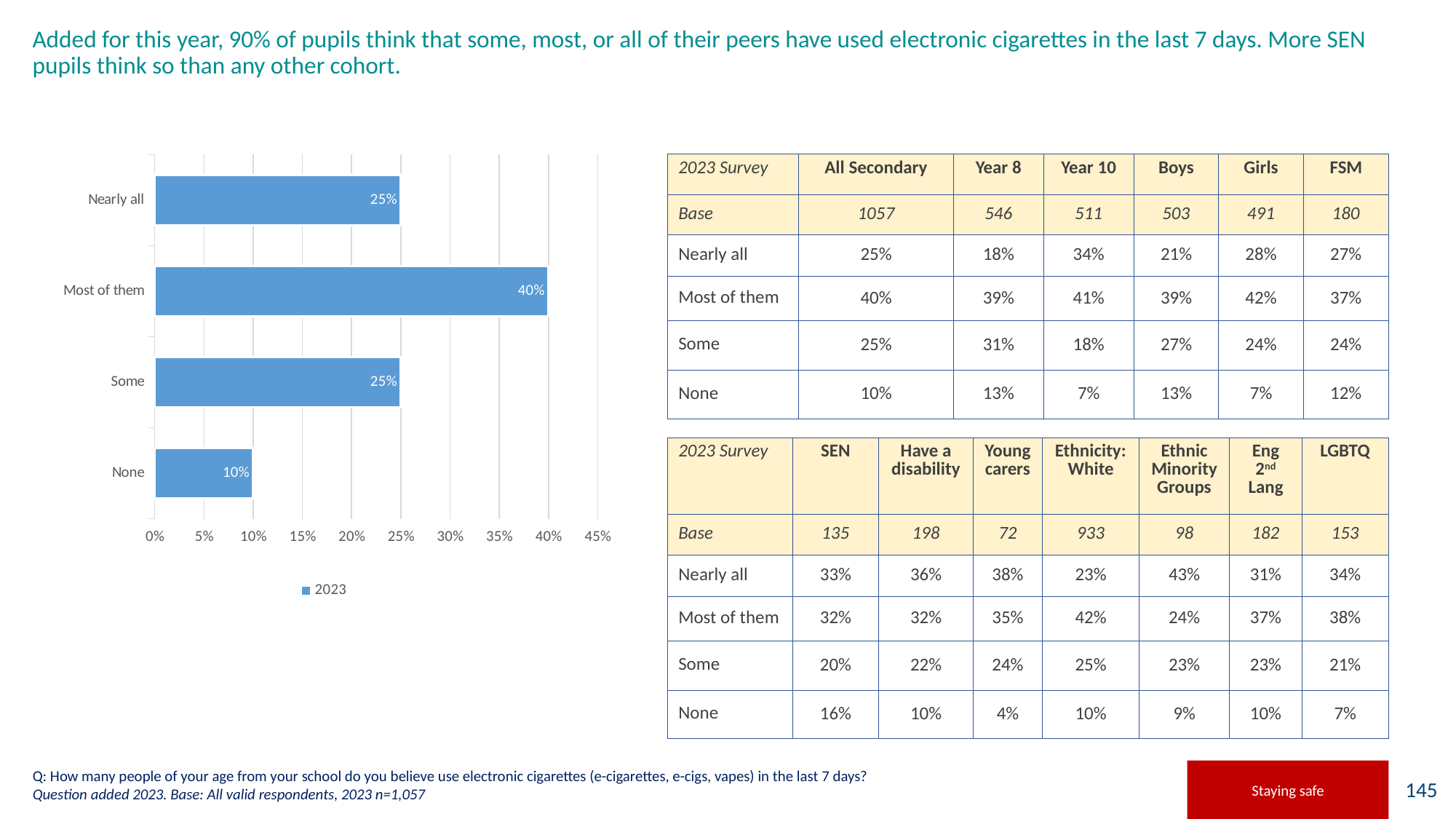
How many categories are shown in the bar chart? 4 What is the difference between the values for "Most of them" and "None" in the bar chart? 30% How many series does the legend of the bar chart list? 1 What type of chart is shown on the slide? Bar chart Which category has the highest value in the bar chart? Most of them Which is larger in the bar chart, the value for "Some" or the value for "None"? Some What is the legend entry shown below the bar chart? 2023 What is the value for "None" in the bar chart? 10% What is the value for "Most of them" in the bar chart? 40% What is the difference between the values for "Most of them" and "Some" in the bar chart? 15% Which category has the lowest value in the bar chart? None What is the value for "Nearly all" in the bar chart? 25%